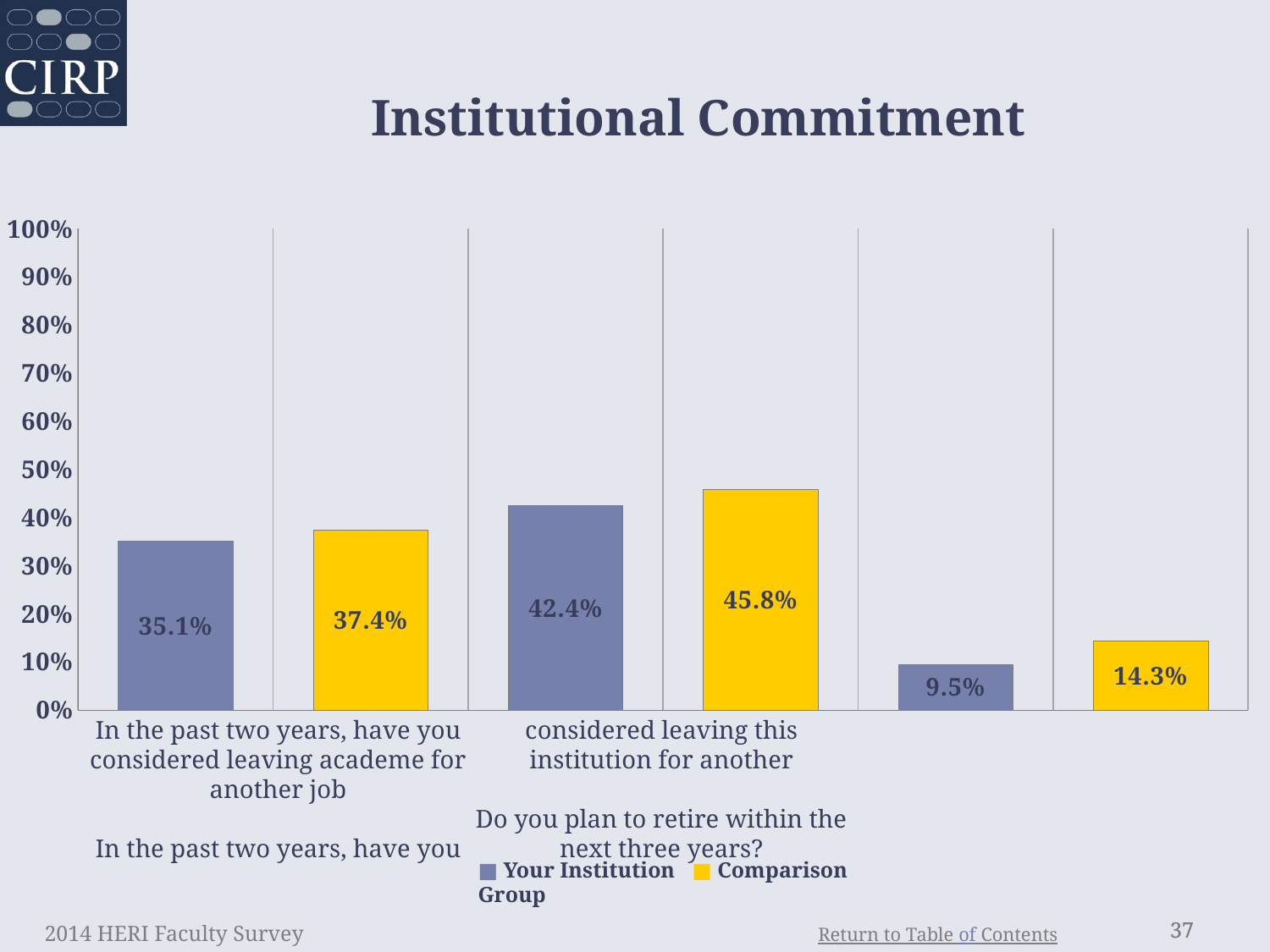
What is the Comparison Group value for "Do you plan to retire within the next three years?"? 14.3% Which question has the highest Comparison Group value? In the past two years, have you considered leaving this institution for another For "In the past two years, have you considered leaving this institution for another", which is larger: Your Institution or Comparison Group? Comparison Group Which question has the lowest Your Institution value? Do you plan to retire within the next three years? What is the Your Institution value for "In the past two years, have you considered leaving academe for another job"? 35.1% What is the title of the chart? Institutional Commitment What is the Your Institution value for "In the past two years, have you considered leaving this institution for another"? 42.4% How many survey questions (categories) are shown on the x axis? 3 What is the Comparison Group value for "In the past two years, have you considered leaving academe for another job"? 37.4% What kind of chart is shown on the slide? Bar chart What is the difference between the Comparison Group and Your Institution values for "Do you plan to retire within the next three years?"? 4.8% How many series does the legend list? 2